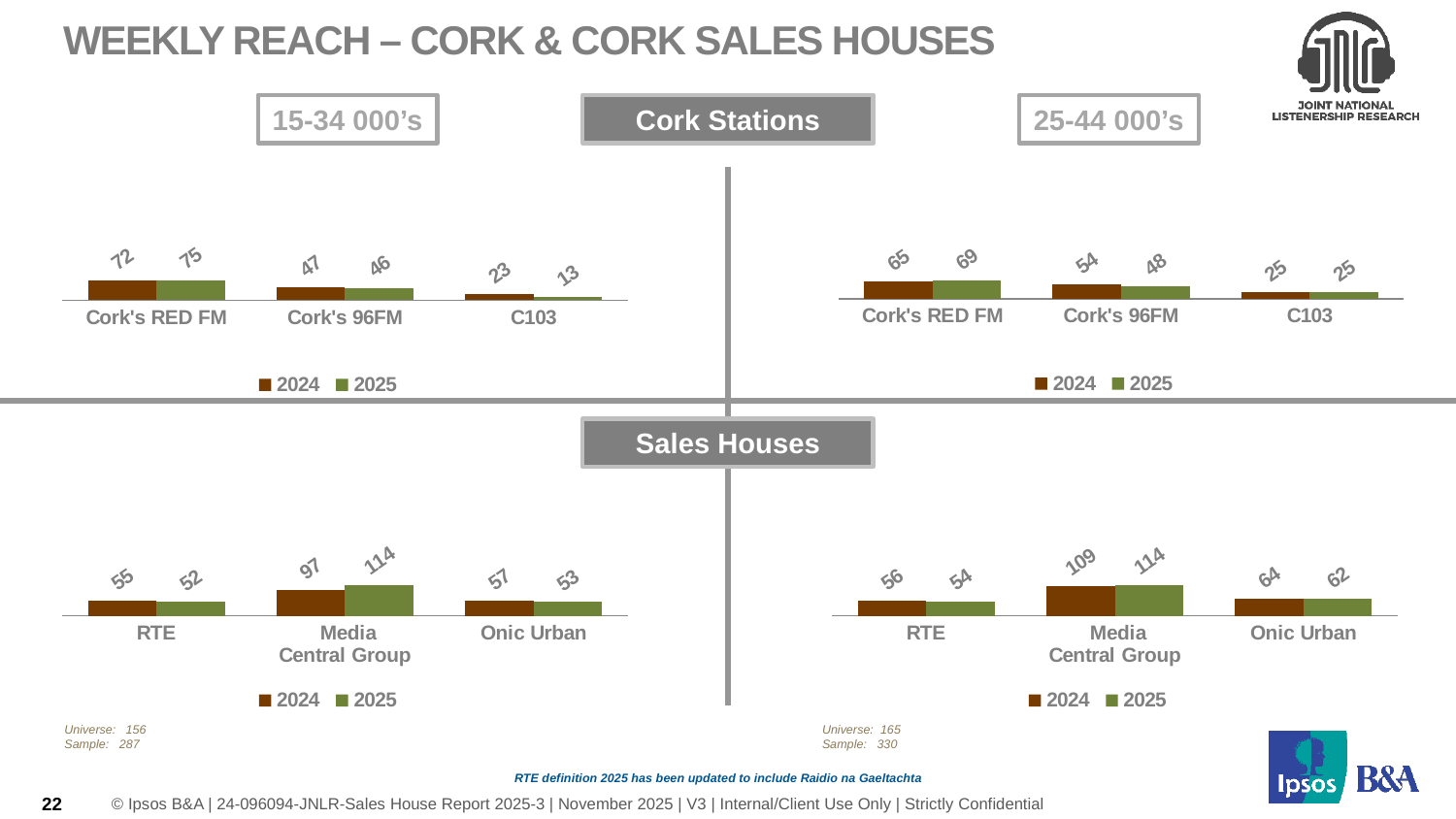
In the top-left chart (Cork Stations, 15-34 000's), what is the difference between the 2024 and 2025 values for C103? 10 In the bottom-right chart (Sales Houses, 25-44 000's), what is the 2024 value for Onic Urban? 64 In the top-right chart (Cork Stations, 25-44 000's), what is the 2025 value for Cork's 96FM? 48 How many series does the legend list in the bottom-right chart (Sales Houses, 25-44 000's)? 2 In the bottom-left chart (Sales Houses, 15-34 000's), which sales house has the lowest 2025 value? RTE In the bottom-right chart (Sales Houses, 25-44 000's), what is the difference between the 2025 and 2024 values for Media Central Group? 5 In the top-right chart (Cork Stations, 25-44 000's), which station has the highest 2025 value? Cork's RED FM What kind of chart is the top-left chart (Cork Stations, 15-34 000's)? bar chart In the bottom-left chart (Sales Houses, 15-34 000's), what is the 2025 value for Media Central Group? 114 In the top-right chart (Cork Stations, 25-44 000's), is the 2024 value for Cork's RED FM larger or smaller than its 2025 value? smaller In the top-left chart (Cork Stations, 15-34 000's), what is the 2024 value for C103? 23 In the top-left chart (Cork Stations, 15-34 000's), what is the 2025 value for Cork's RED FM? 75